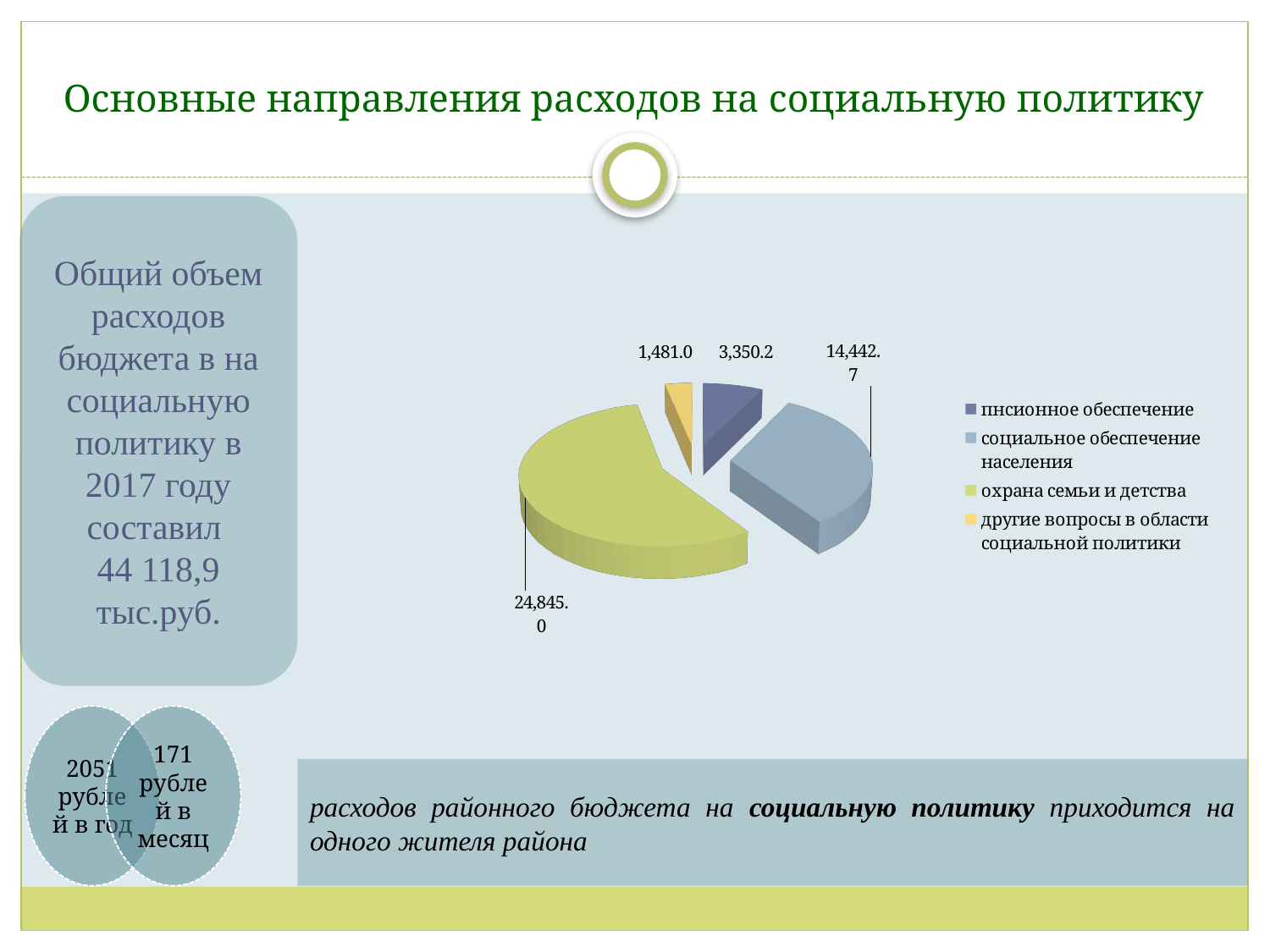
What value is shown for the slice "другие вопросы в области социальной политики"? 1,481.0 What value is shown for the slice "пнсионное обеспечение"? 3,350.2 What value is shown for the slice "охрана семьи и детства"? 24,845.0 Which category has the largest slice of the pie? охрана семьи и детства How many slices does the pie chart have? 4 What is the difference between the values for "пнсионное обеспечение" and "другие вопросы в области социальной политики"? 1,869.2 What colour is the slice for "охрана семьи и детства"? green Which is larger, the value for "социальное обеспечение населения" or the value for "пнсионное обеспечение"? социальное обеспечение населения What value is shown for the slice "социальное обеспечение населения"? 14,442.7 What is the difference between the values for "охрана семьи и детства" and "социальное обеспечение населения"? 10,402.3 What kind of chart is shown on the slide? pie chart Which category has the smallest slice of the pie? другие вопросы в области социальной политики